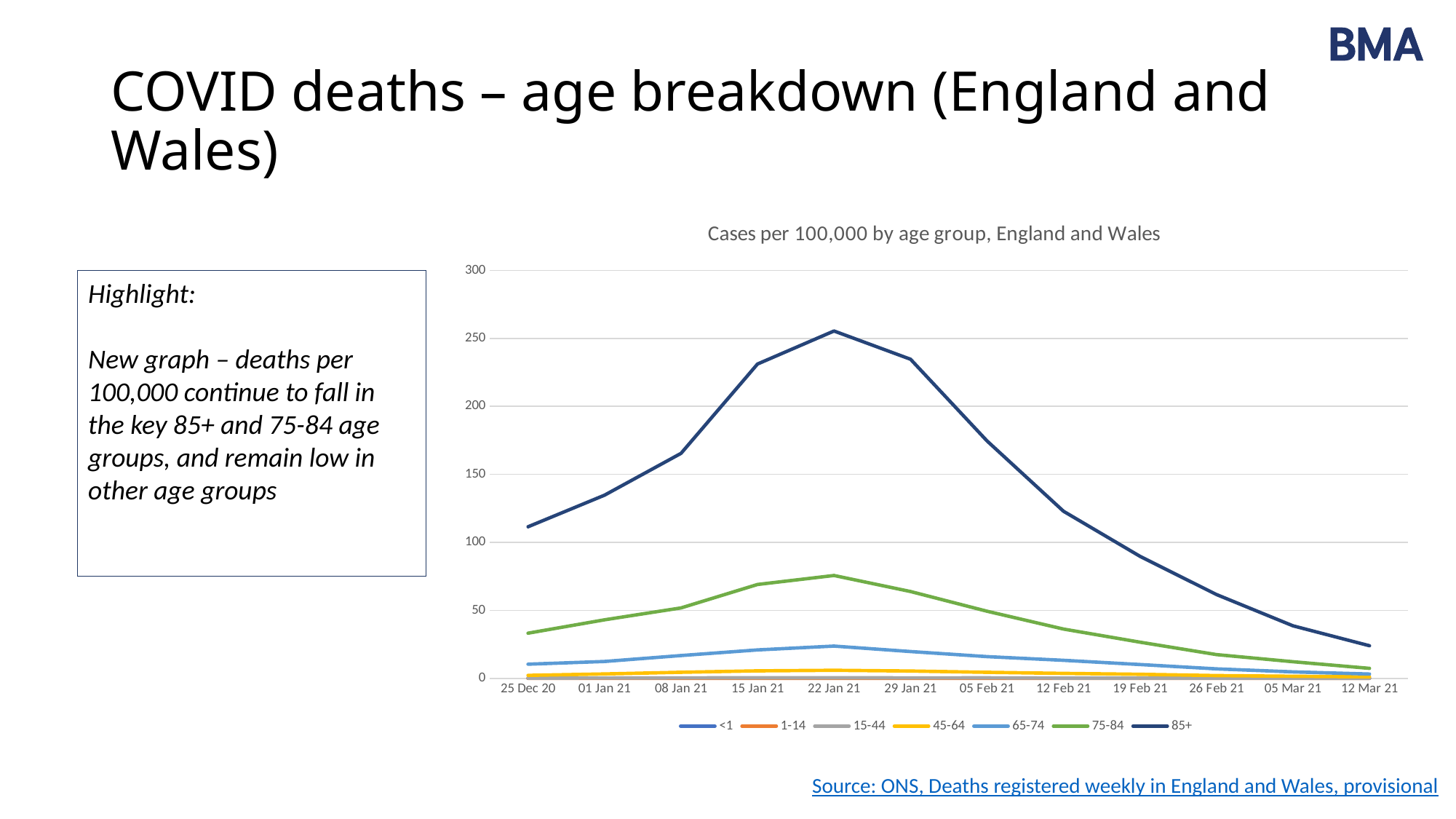
Which age group has the highest values across the chart? 85+ Is the value for the 85+ group on 22 Jan 21 greater or less than 250? greater Is the value for the 85+ group on 25 Dec 20 greater or less than 100? greater How many dates are plotted along the x axis? 12 Which is larger on 22 Jan 21, the value for the 85+ group or the 75-84 group? 85+ Is the value for the 85+ group on 12 Mar 21 greater or less than 50? less Does the 85+ series rise or fall from 22 Jan 21 to 12 Mar 21? fall What is the title of the chart? Cases per 100,000 by age group, England and Wales How many series does the legend list? 7 What kind of chart is shown on the slide? line chart On which date does the 85+ series reach its highest value? 22 Jan 21